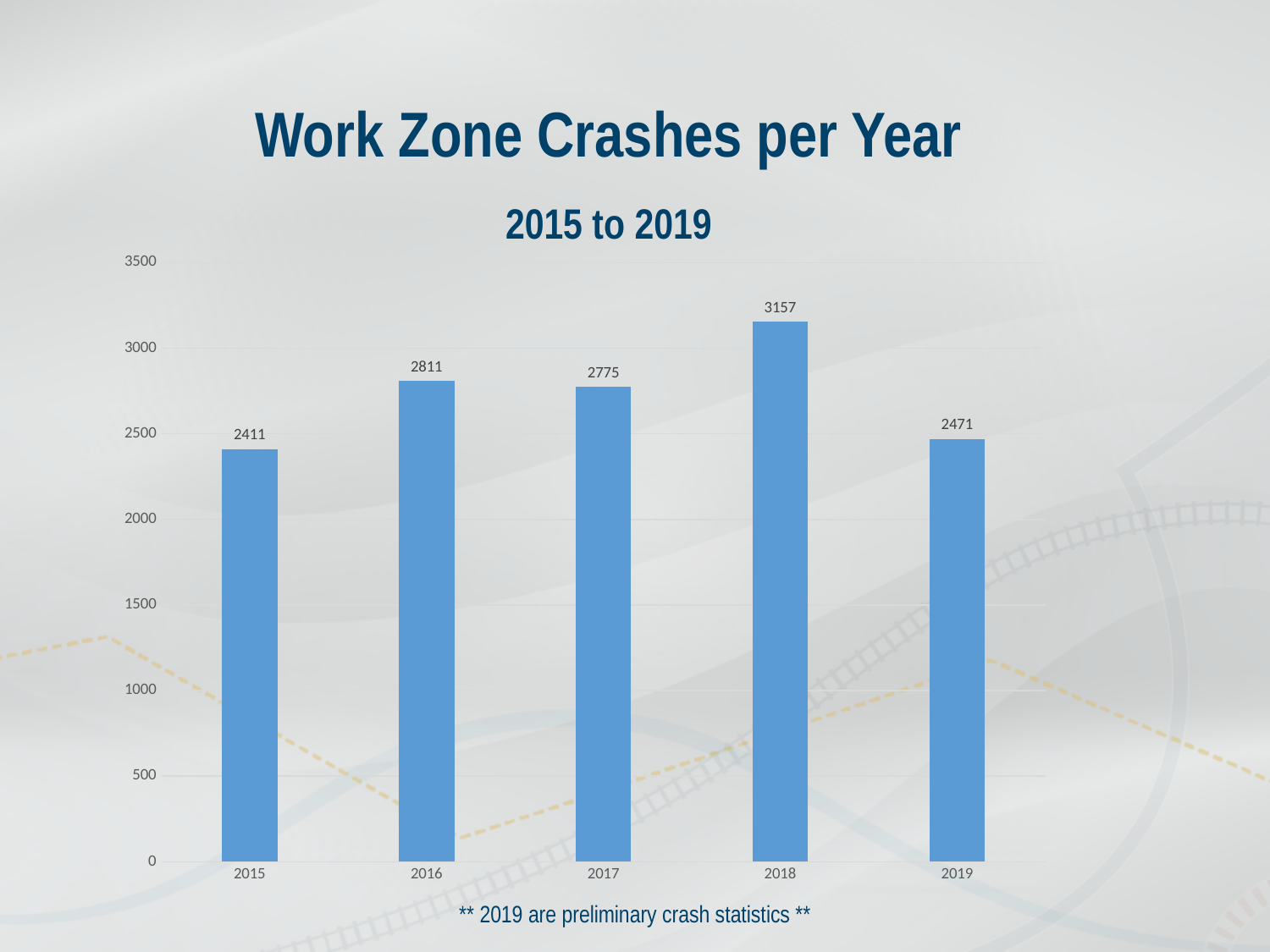
What is the value shown for 2019? 2471 What is the difference between the 2018 and 2019 values? 686 What kind of chart is shown on the slide? bar chart What is the difference between the 2016 and 2017 values? 36 What is the title of the chart? Work Zone Crashes per Year Which year has more work zone crashes, 2016 or 2019? 2016 What is the number of work zone crashes in 2018? 3157 Which year has the highest number of work zone crashes? 2018 Is the value for 2018 greater or less than 3000? greater Which year has the lowest number of work zone crashes? 2015 What is the number of work zone crashes in 2015? 2411 How many years are shown on the x axis? 5